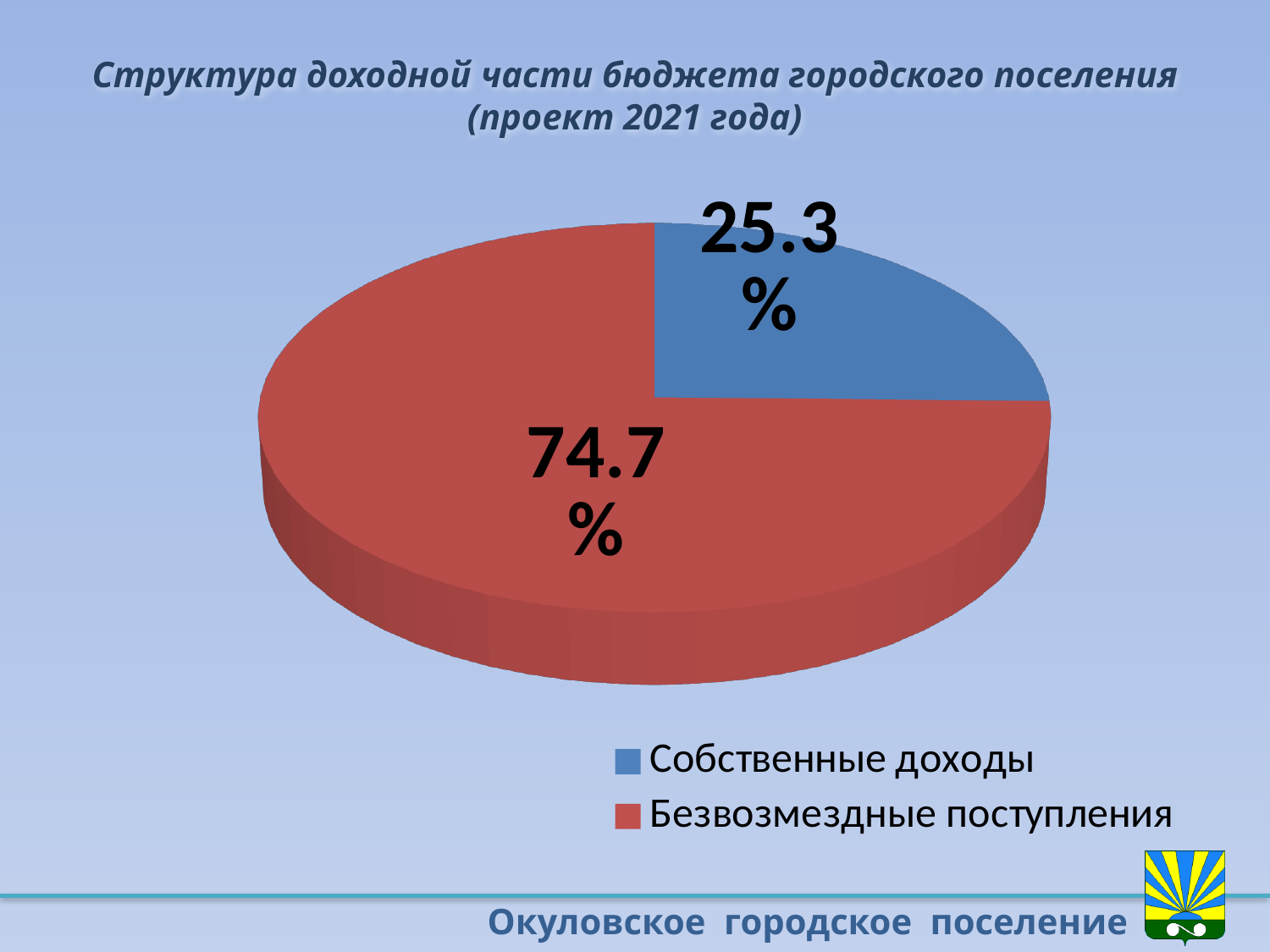
How many slices does the pie chart have? 2 What colour is the slice for Собственные доходы? Blue What kind of chart is shown on the slide? Pie chart What share of the pie does Безвозмездные поступления represent? 74.7% What is the difference in percentage points between Безвозмездные поступления and Собственные доходы? 49.4 Which category has the largest slice of the pie? Безвозмездные поступления How many entries does the legend list? 2 What share of the pie does Собственные доходы represent? 25.3% Which is larger: Собственные доходы or Безвозмездные поступления? Безвозмездные поступления Which category has the smallest slice of the pie? Собственные доходы What is the title of the chart? Структура доходной части бюджета городского поселения (проект 2021 года)